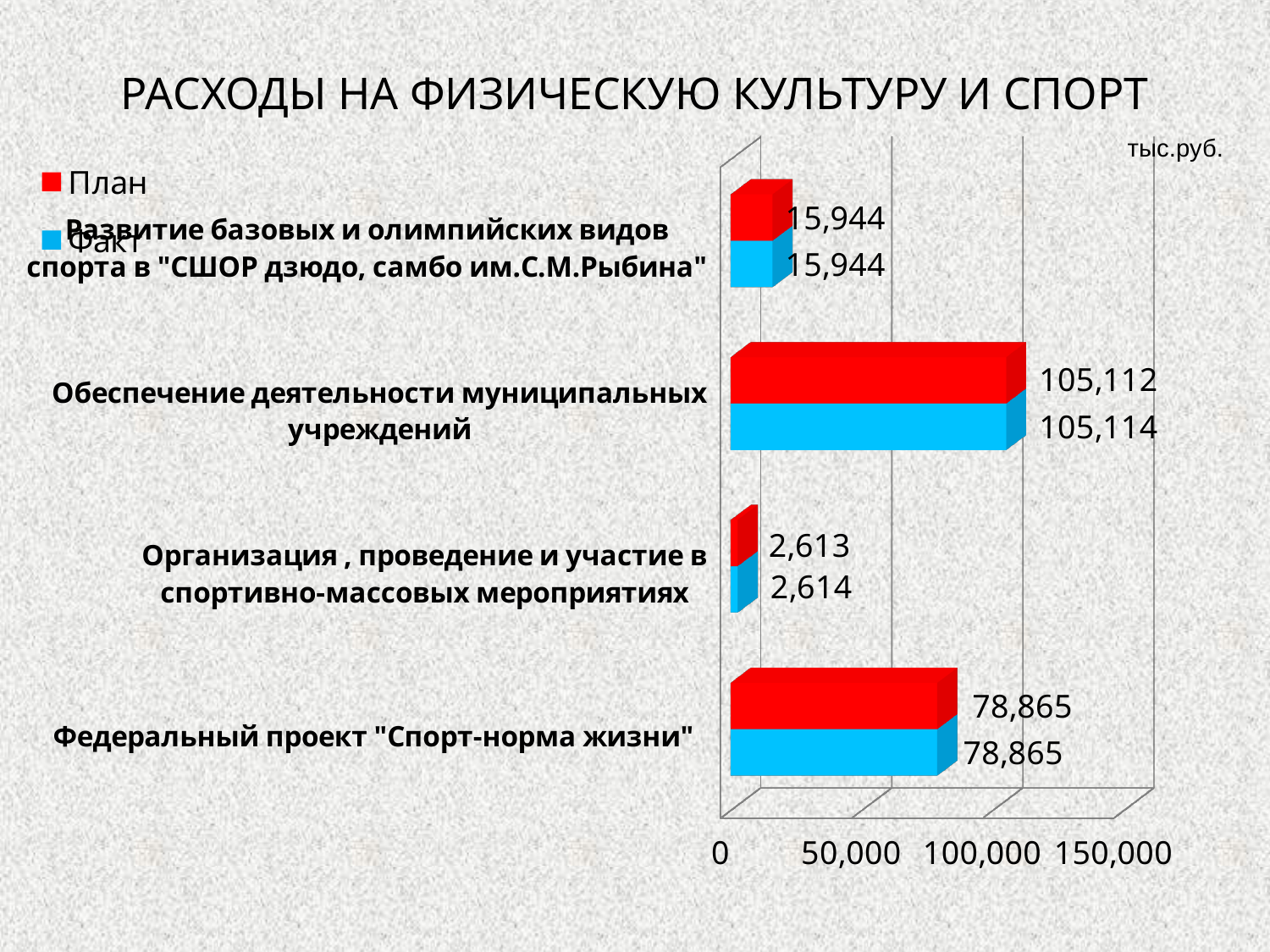
What is the План value for "Организация, проведение и участие в спортивно-массовых мероприятиях"? 2,613 How many categories are shown in the chart? 4 What is the План value for "Обеспечение деятельности муниципальных учреждений"? 105,112 Which is larger: the План value for "Федеральный проект "Спорт-норма жизни"" or the План value for "Развитие базовых и олимпийских видов спорта в "СШОР дзюдо, самбо им.С.М.Рыбина""? Федеральный проект "Спорт-норма жизни" What is the difference between the Факт and План values for "Обеспечение деятельности муниципальных учреждений"? 2 What is the План value for "Развитие базовых и олимпийских видов спорта в "СШОР дзюдо, самбо им.С.М.Рыбина""? 15,944 Which category has the highest План value? Обеспечение деятельности муниципальных учреждений How many series does the legend list? 2 What is the Факт value for "Обеспечение деятельности муниципальных учреждений"? 105,114 Is the План value for "Обеспечение деятельности муниципальных учреждений" greater or less than 100,000? greater Which category has the lowest Факт value? Организация, проведение и участие в спортивно-массовых мероприятиях What is the Факт value for "Федеральный проект "Спорт-норма жизни""? 78,865